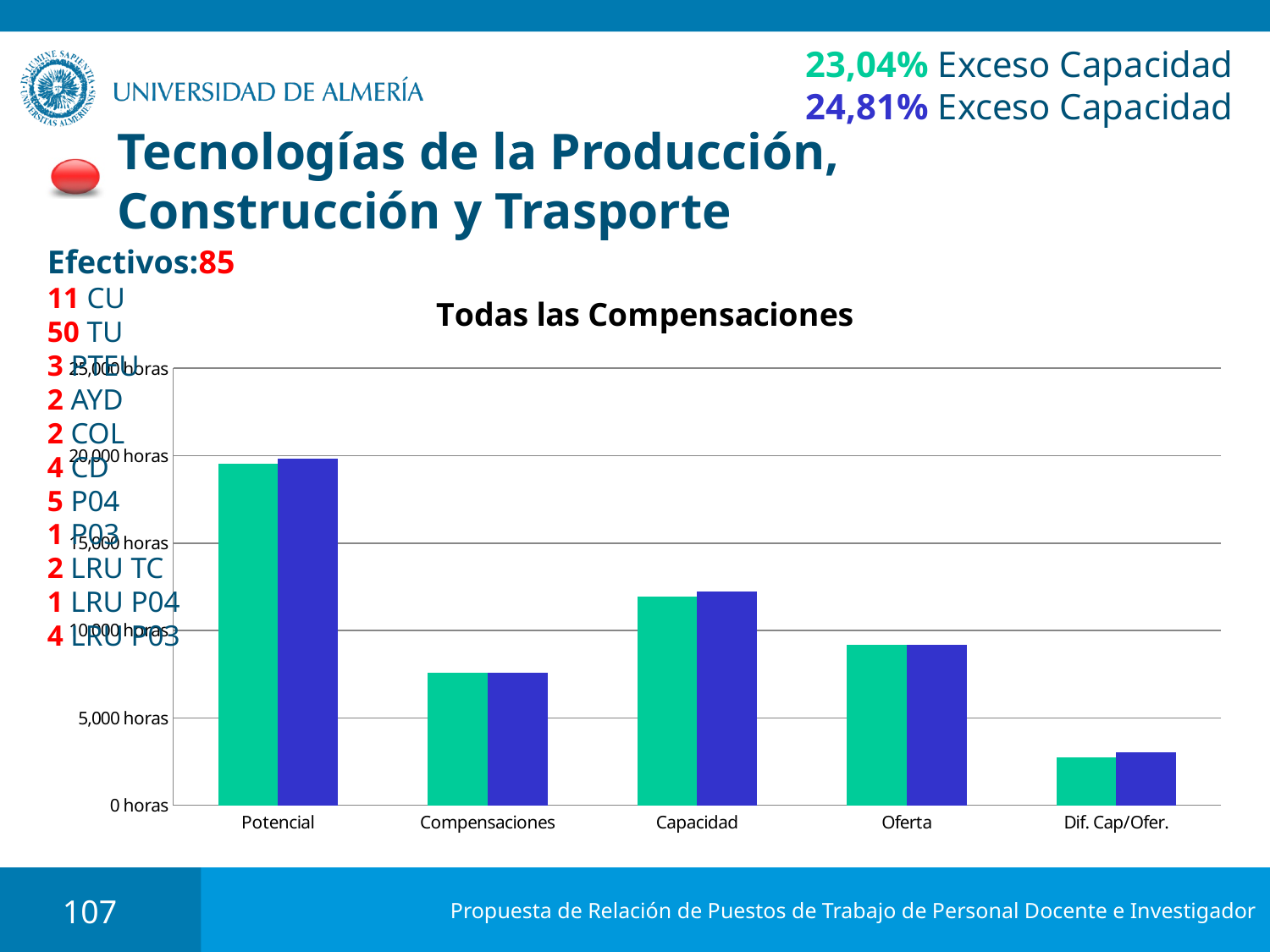
Which is larger, the green bar for Capacidad or the green bar for Oferta? Capacidad Which category has the lowest bars in the chart? Dif. Cap/Ofer. Is the value of the green bar for Potencial greater or less than 15,000 horas? greater Is the value of the blue bar for Capacidad greater or less than 10,000 horas? greater What kind of chart is shown on the slide? bar chart What is the title of the chart? Todas las Compensaciones Is the value of the green bar for Oferta greater or less than 10,000 horas? less Which category has the highest bars in the chart? Potencial How many categories are shown on the x axis of the chart? 5 How many bars are plotted for each category in the chart? 2